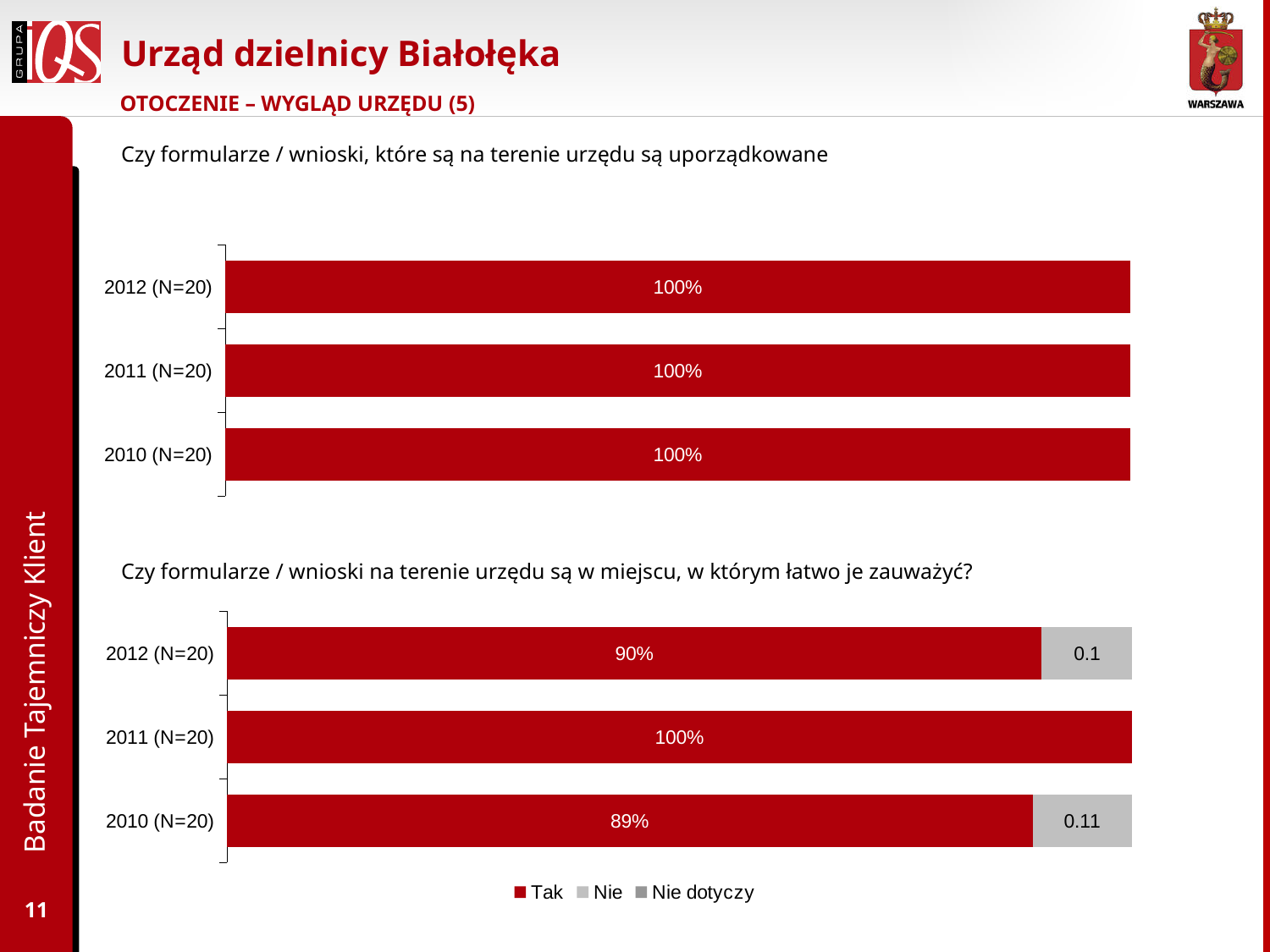
In the bottom chart ("Czy formularze / wnioski na terenie urzędu są w miejscu, w którym łatwo je zauważyć?"), which year has the lowest Tak value? 2010 (N=20) In the bottom chart ("Czy formularze / wnioski na terenie urzędu są w miejscu, w którym łatwo je zauważyć?"), what is the Nie value labelled for 2010 (N=20)? 0.11 In the bottom chart ("Czy formularze / wnioski na terenie urzędu są w miejscu, w którym łatwo je zauważyć?"), is the Tak value for 2012 (N=20) larger or smaller than the Tak value for 2010 (N=20)? larger In the bottom chart ("Czy formularze / wnioski na terenie urzędu są w miejscu, w którym łatwo je zauważyć?"), what is the Tak value for 2012 (N=20)? 90% In the bottom chart ("Czy formularze / wnioski na terenie urzędu są w miejscu, w którym łatwo je zauważyć?"), what is the difference between the Tak value for 2011 (N=20) and the Tak value for 2012 (N=20)? 10% What kind of chart is the top chart on the slide? bar chart In the top chart ("Czy formularze / wnioski, które są na terenie urzędu są uporządkowane"), how many categories are plotted? 3 In the bottom chart ("Czy formularze / wnioski na terenie urzędu są w miejscu, w którym łatwo je zauważyć?"), what is the Tak value for 2010 (N=20)? 89% How many series does the legend under the bottom chart list? 3 In the top chart ("Czy formularze / wnioski, które są na terenie urzędu są uporządkowane"), what is the value shown for 2012 (N=20)? 100% In the bottom chart ("Czy formularze / wnioski na terenie urzędu są w miejscu, w którym łatwo je zauważyć?"), which year has the highest Tak value? 2011 (N=20) In the bottom chart ("Czy formularze / wnioski na terenie urzędu są w miejscu, w którym łatwo je zauważyć?"), what is the Nie value labelled for 2012 (N=20)? 0.1